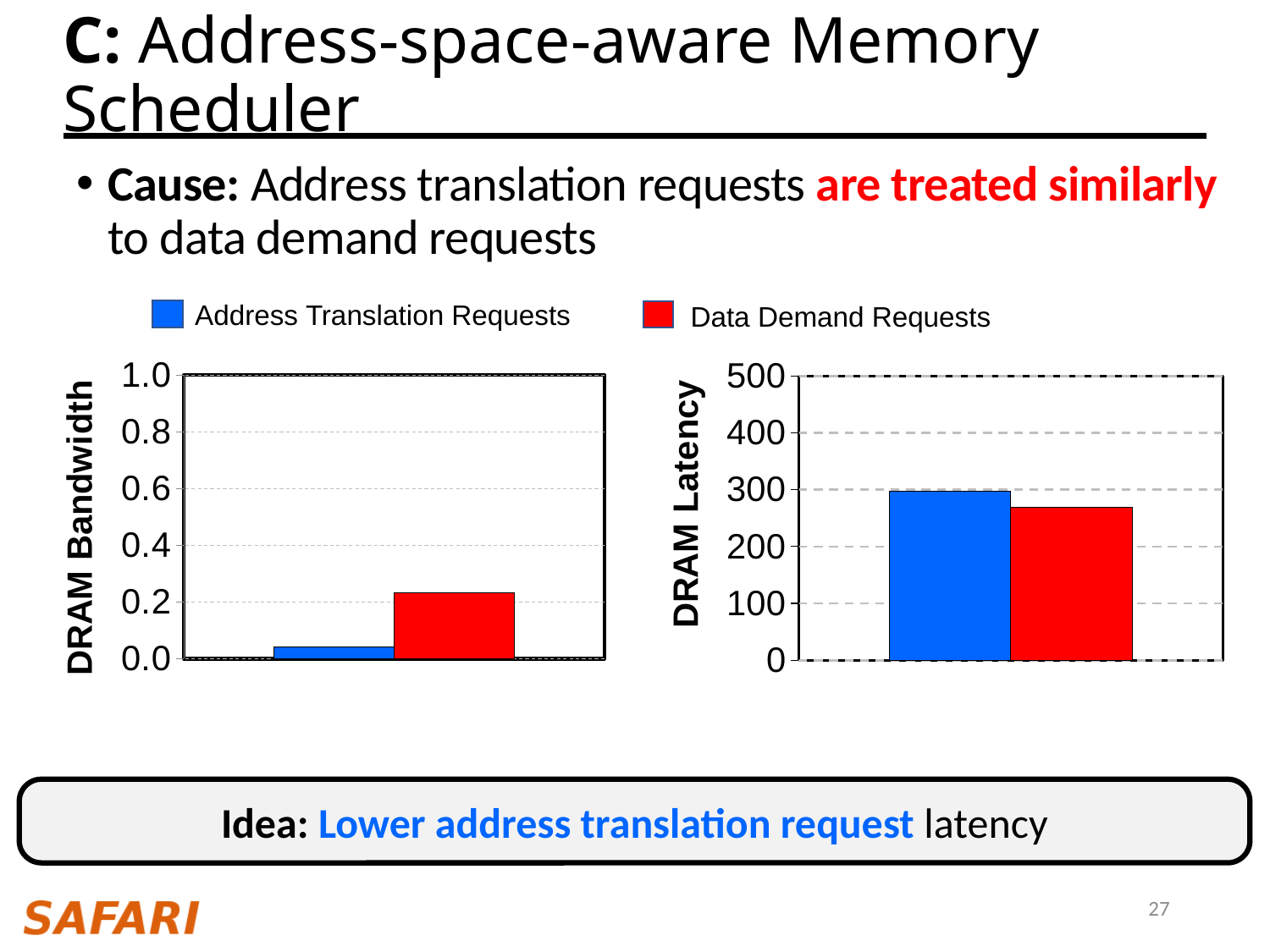
What colour represents Data Demand Requests in the legend? red What is the y-axis label of the chart on the right? DRAM Latency In the DRAM Latency chart, is the value for Data Demand Requests greater or less than 300? less What kind of chart is the DRAM Bandwidth chart on the left? bar chart In the DRAM Bandwidth chart, is the value for Data Demand Requests greater or less than 0.4? less In the DRAM Latency chart, which series has the higher latency? Address Translation Requests In the DRAM Latency chart, is the value for Address Translation Requests greater or less than 200? greater How many series does the legend list? 2 In the DRAM Bandwidth chart, which series has the higher value, Address Translation Requests or Data Demand Requests? Data Demand Requests In the DRAM Bandwidth chart, which series has the lowest value? Address Translation Requests